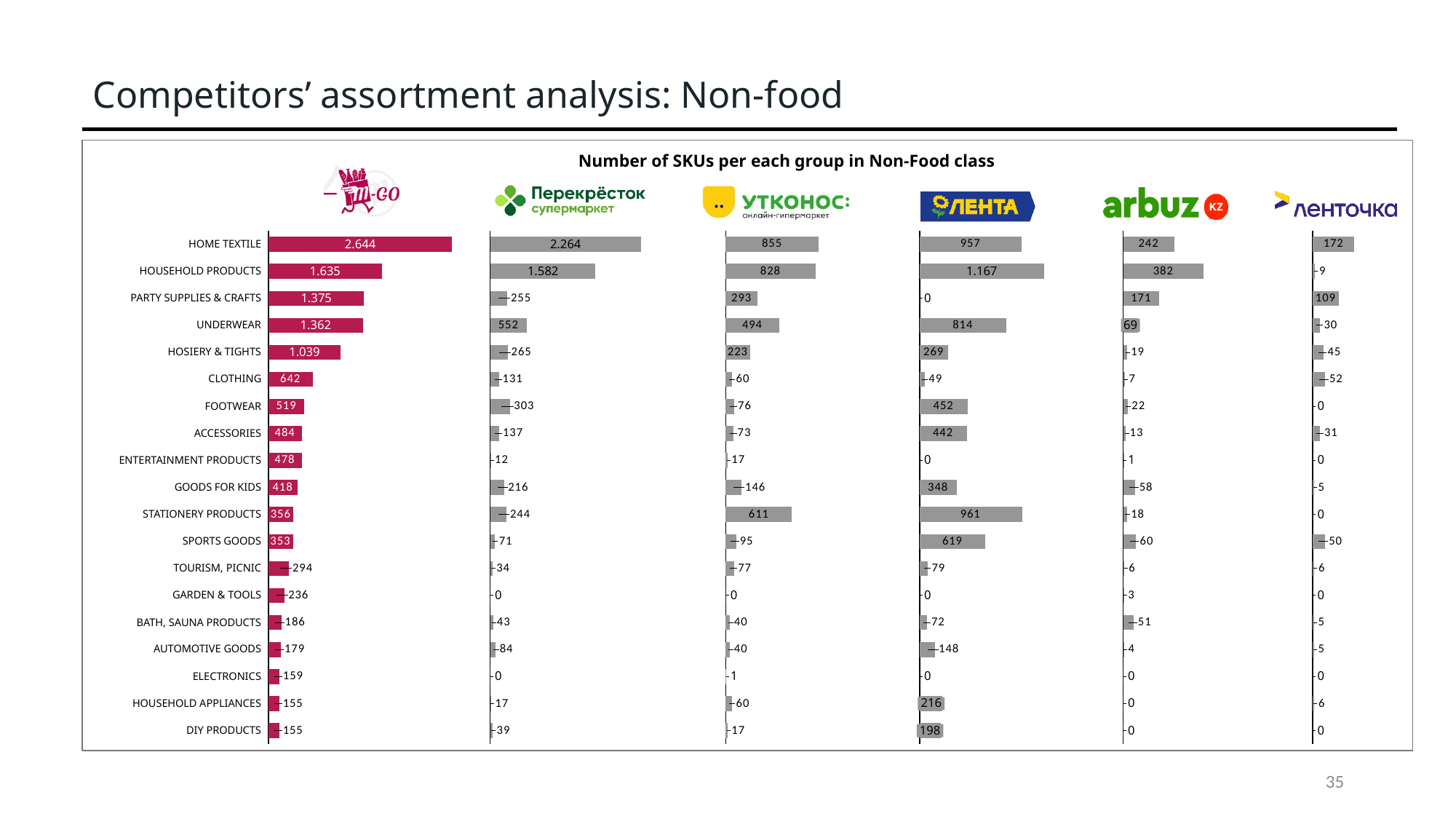
In the Лента chart, what is the difference between UNDERWEAR and FOOTWEAR? 362 How many product categories are listed on the slide's charts? 19 In the Лента chart, which category has the highest number of SKUs? HOUSEHOLD PRODUCTS In the leftmost chart (red bars), what is the number of SKUs for HOME TEXTILE? 2.644 What type of chart is used on this slide? Bar chart In the ленточка chart (rightmost), what is the value for HOME TEXTILE? 172 In the Перекрёсток chart, what is the value for HOUSEHOLD PRODUCTS? 1.582 In the leftmost chart (red bars), do the values rise or fall going from the top category to the bottom category? Fall For UNDERWEAR, which chart shows a larger value: Перекрёсток or Утконос? Перекрёсток In the Утконос chart, what is the value for STATIONERY PRODUCTS? 611 What is the title shown above the charts? Number of SKUs per each group in Non-Food class In the arbuz chart, which category has the highest value? HOUSEHOLD PRODUCTS